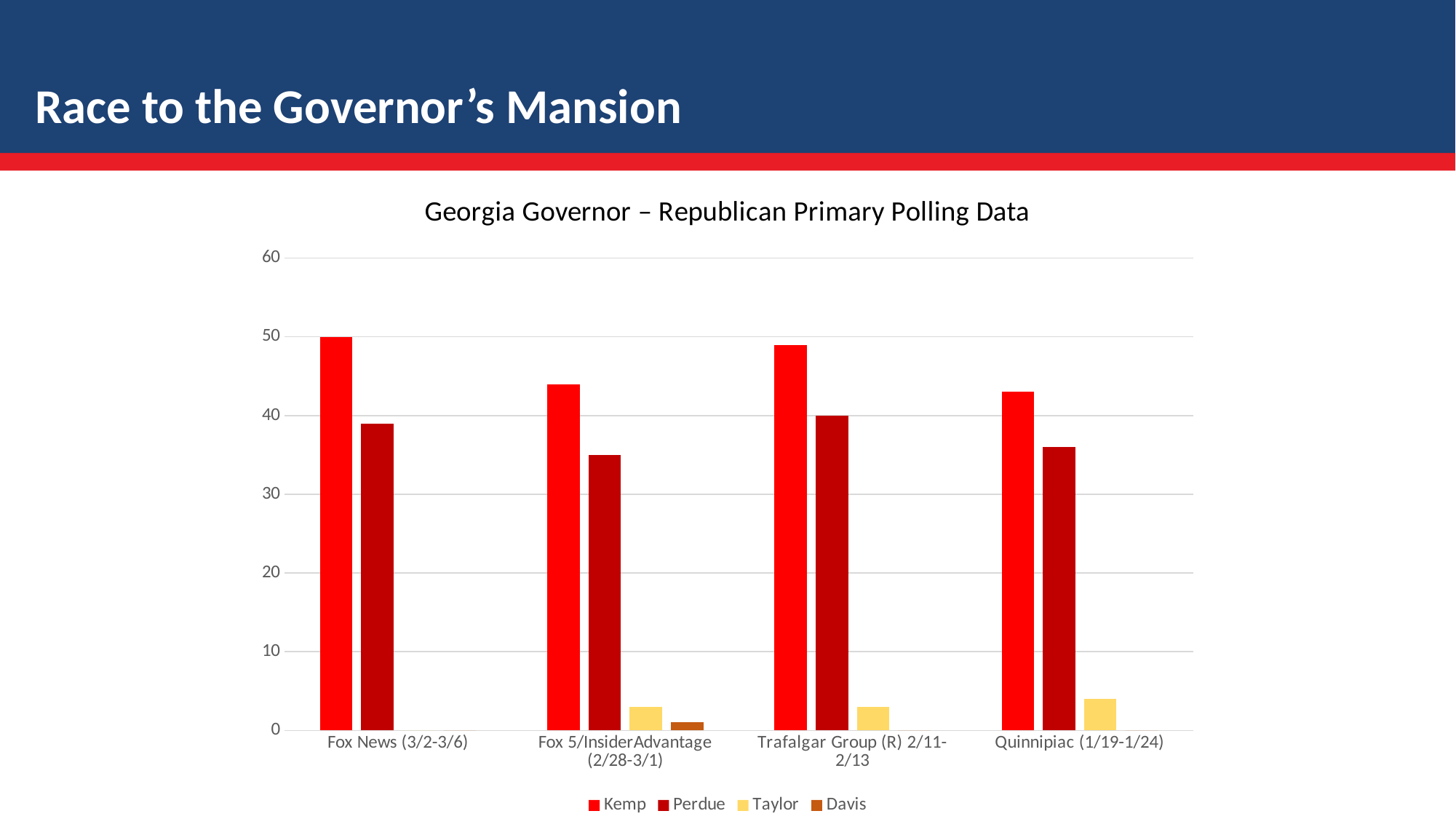
How many series does the legend list? 4 Is Taylor's value in the Quinnipiac (1/19-1/24) poll greater or less than 10? less In which poll is Kemp's value highest? Fox News (3/2-3/6) What is Perdue's value in the Trafalgar Group (R) 2/11-2/13 poll? 40 In the Quinnipiac (1/19-1/24) poll, who has the larger value, Kemp or Perdue? Kemp Is Kemp's value in the Fox 5/InsiderAdvantage (2/28-3/1) poll greater or less than 40? greater How many polls (categories) are shown on the x axis? 4 What is Kemp's value in the Fox News (3/2-3/6) poll? 50 Is Perdue's value in the Fox 5/InsiderAdvantage (2/28-3/1) poll greater or less than 40? less What type of chart is shown on the slide? Bar chart In which poll is Kemp's value lowest? Quinnipiac (1/19-1/24) What is the title of the chart? Georgia Governor – Republican Primary Polling Data